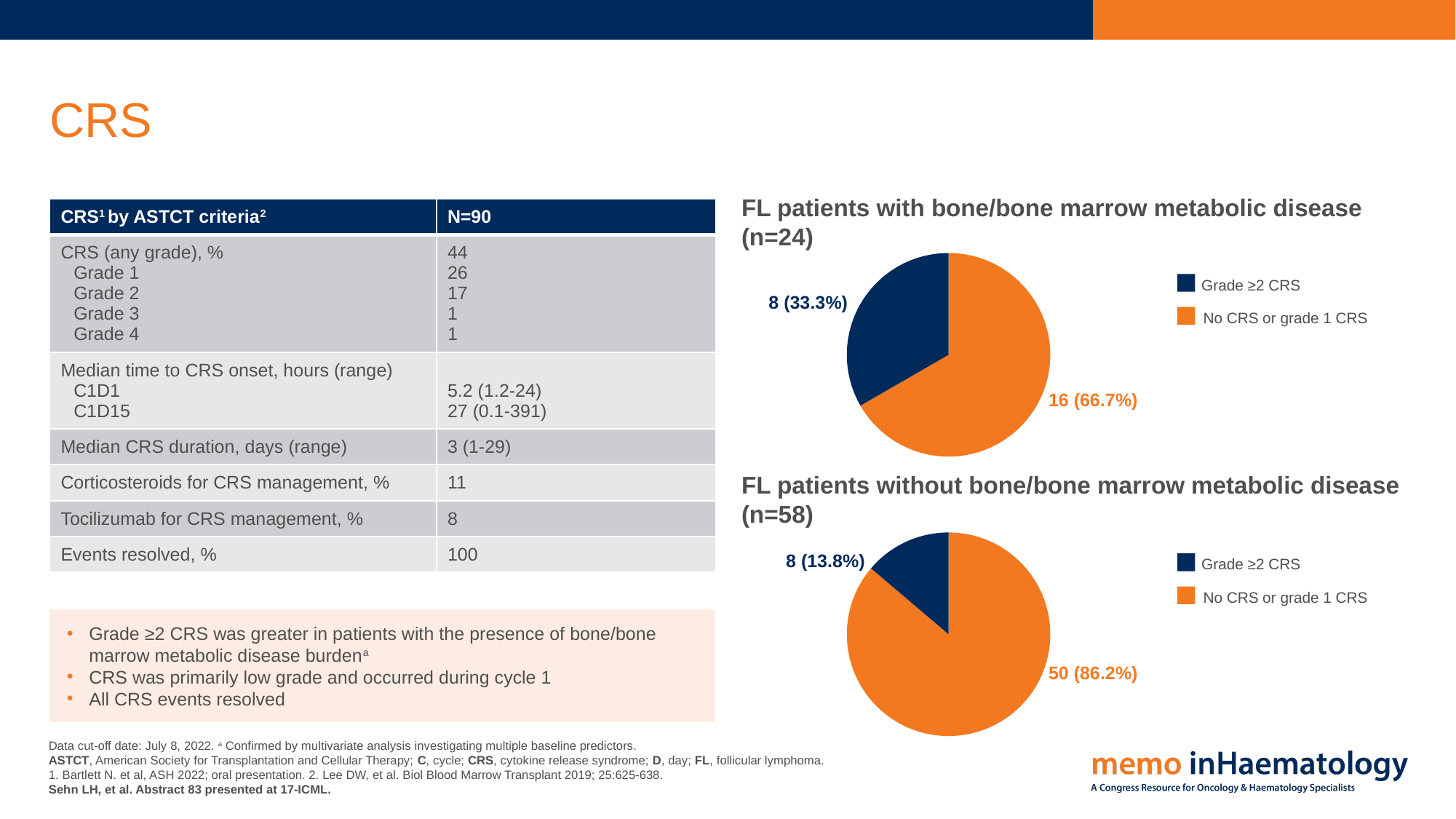
In the pie chart for FL patients without bone/bone marrow metabolic disease (n=58), which category has the smallest slice? Grade ≥2 CRS In the pie chart for FL patients without bone/bone marrow metabolic disease (n=58), how many patients had No CRS or grade 1 CRS? 50 In the pie chart for FL patients with bone/bone marrow metabolic disease (n=24), which category has the larger slice? No CRS or grade 1 CRS What type of chart is used to show CRS in FL patients with bone/bone marrow metabolic disease? Pie chart Is the Grade ≥2 CRS percentage larger in the chart for patients with bone/bone marrow metabolic disease or in the chart for patients without it? With bone/bone marrow metabolic disease In the pie chart for FL patients with bone/bone marrow metabolic disease (n=24), how many patients had Grade ≥2 CRS? 8 How many categories does the legend list for the pie chart of FL patients without bone/bone marrow metabolic disease (n=58)? 2 In the pie chart for FL patients with bone/bone marrow metabolic disease (n=24), what percentage of patients had No CRS or grade 1 CRS? 66.7% In the pie chart for FL patients with bone/bone marrow metabolic disease (n=24), what is the difference in patient count between the No CRS or grade 1 CRS slice and the Grade ≥2 CRS slice? 8 In the pie chart for FL patients without bone/bone marrow metabolic disease (n=58), what share of patients had Grade ≥2 CRS? 13.8% In the pie charts, which colour represents Grade ≥2 CRS? Dark blue In the pie chart for FL patients without bone/bone marrow metabolic disease (n=58), what is the difference in patient count between the No CRS or grade 1 CRS slice and the Grade ≥2 CRS slice? 42